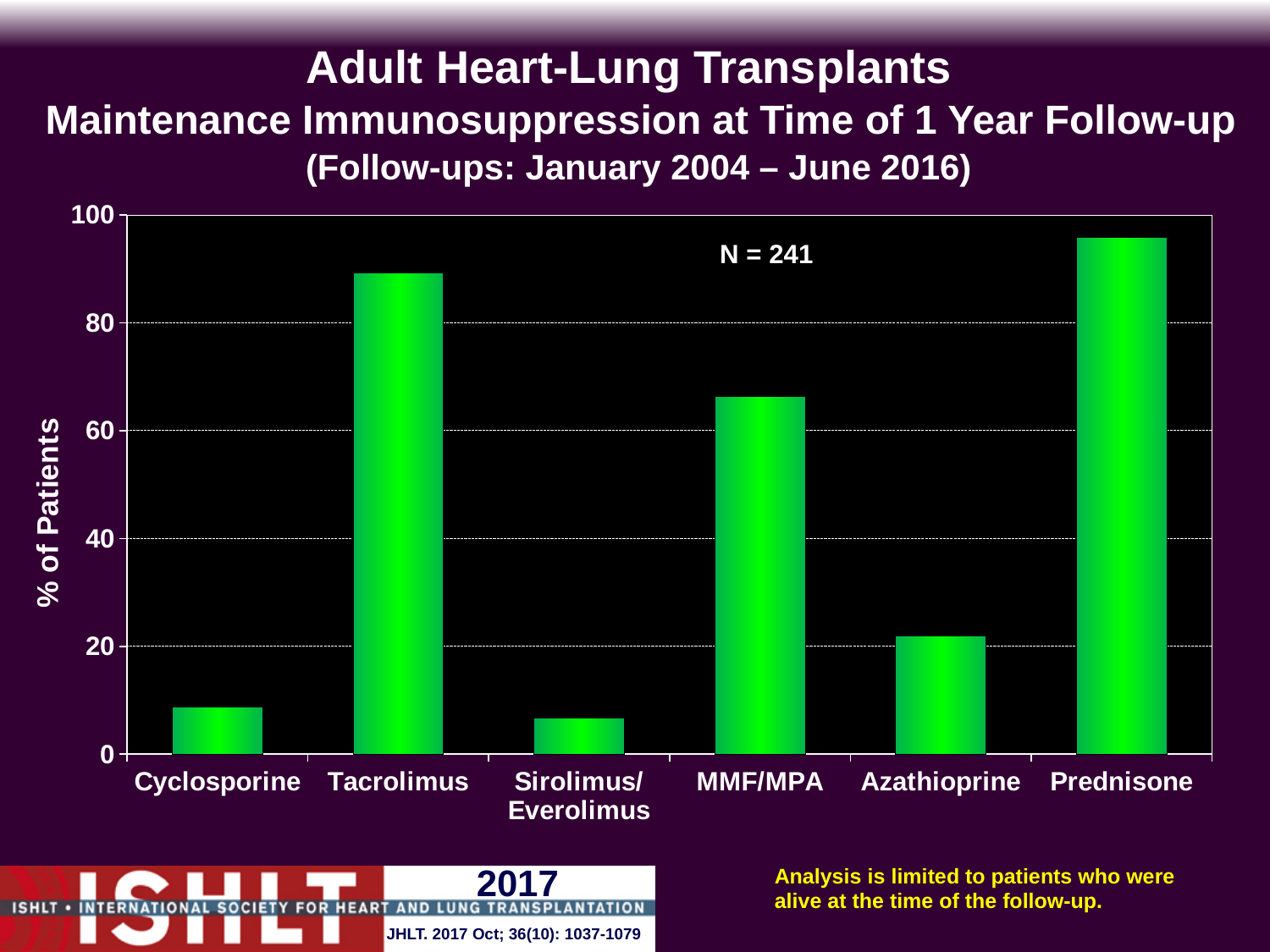
Is the value for Tacrolimus greater or less than 80? greater What kind of chart is shown on the slide? bar chart What is the label of the y axis? % of Patients Is the value for Azathioprine greater or less than 40? less What is the N value shown on the chart? N = 241 Which is larger, the value for Azathioprine or the value for Cyclosporine? Azathioprine How many immunosuppression categories are shown on the x axis? 6 Which category has the highest percentage of patients? Prednisone Which is larger, the value for Tacrolimus or the value for MMF/MPA? Tacrolimus Is the value for Cyclosporine greater or less than 20? less Which category has the lowest percentage of patients? Sirolimus/Everolimus